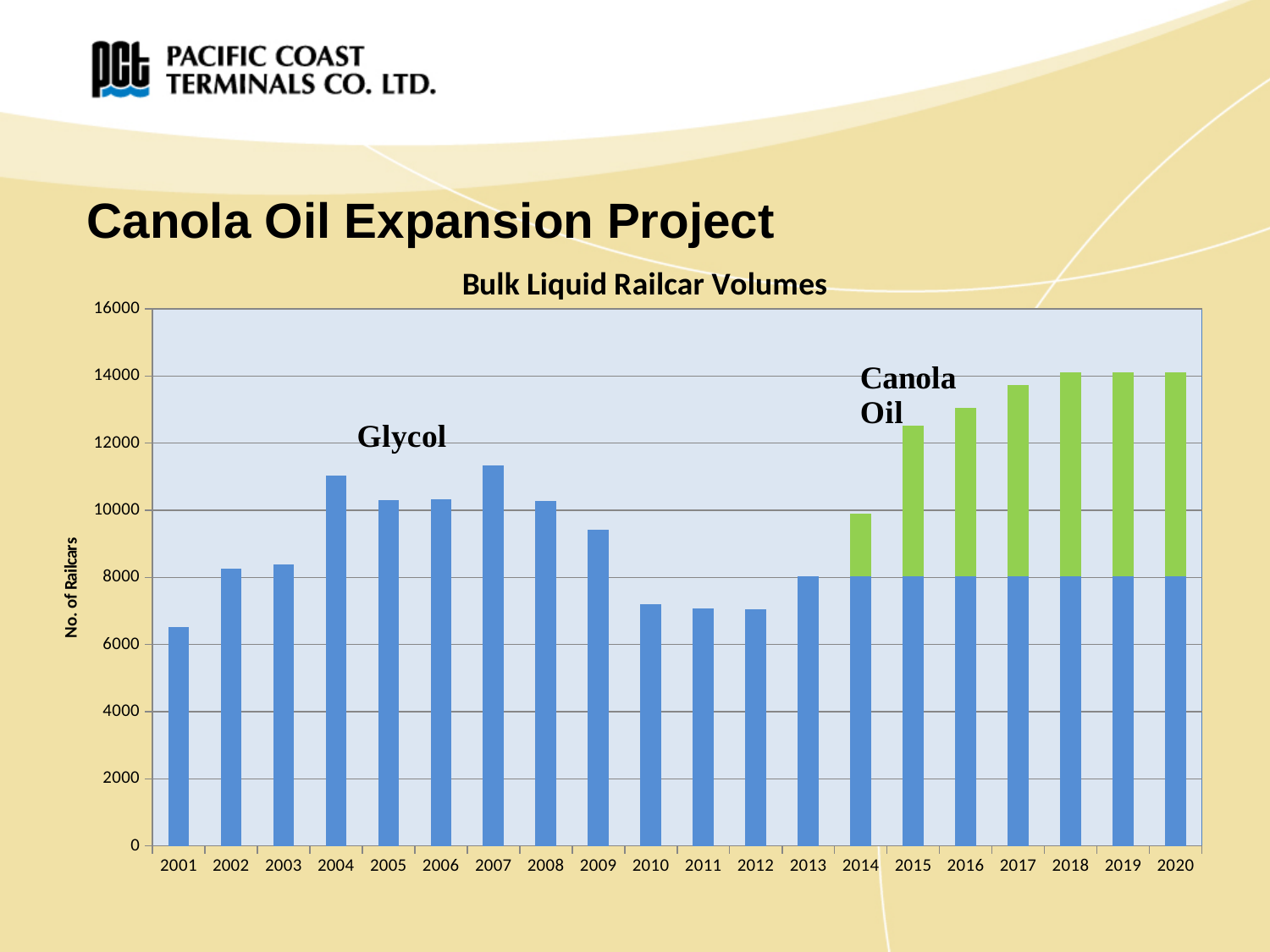
What is the title of the chart? Bulk Liquid Railcar Volumes Is the value for 2007 greater or less than 10000? greater Is the value for 2001 greater or less than 8000? less Which year has the lowest total railcar volume? 2001 Do the total railcar volumes rise or fall from 2014 to 2020? Rise Is the total value for 2017 greater or less than 12000? greater Which year has the larger railcar volume, 2009 or 2010? 2009 How many years are shown along the x axis of the chart? 20 How many data series are plotted in the chart? 2 What is the label on the vertical axis of the chart? No. of Railcars What kind of chart is shown on the slide? Bar chart